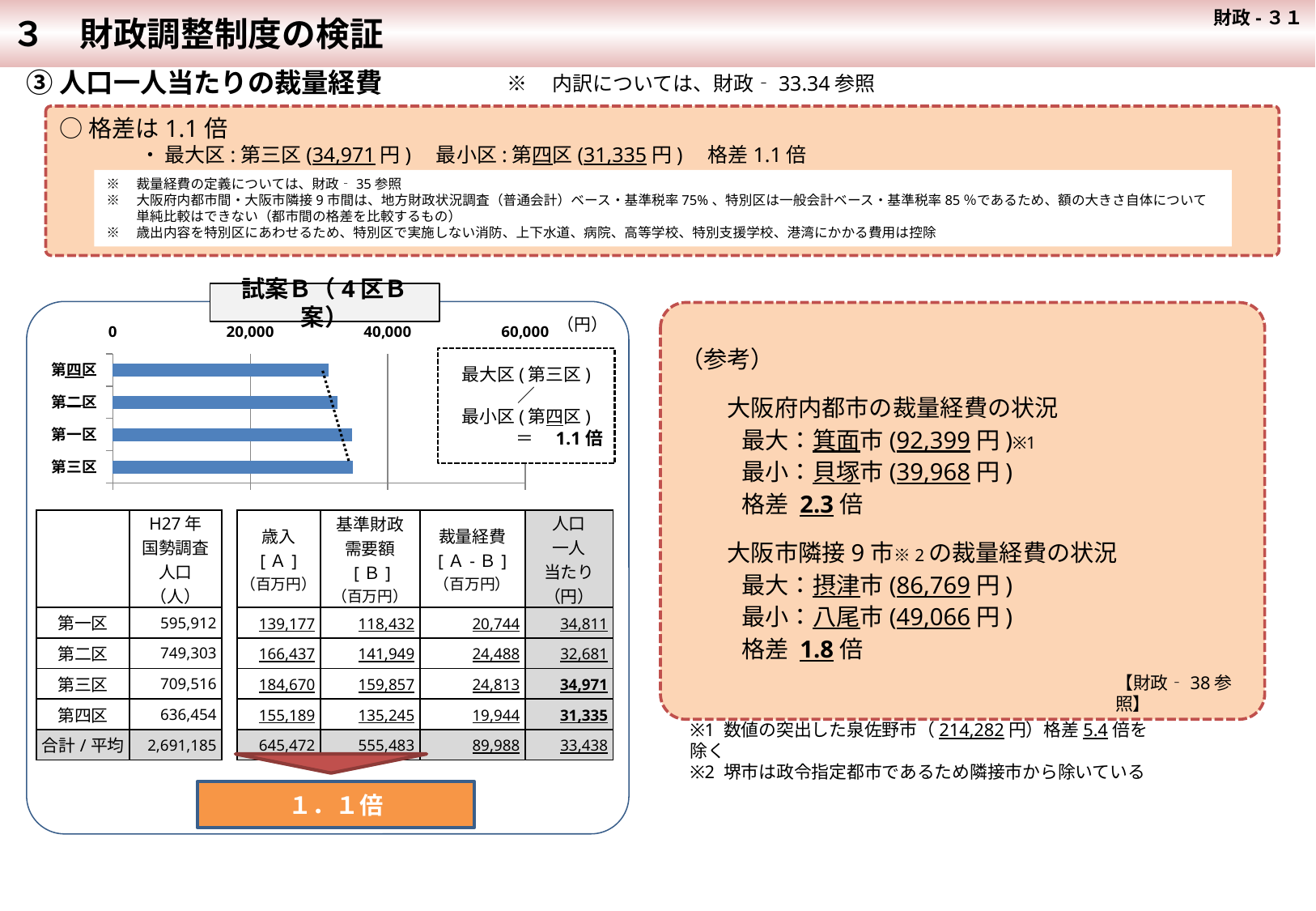
What is the per-capita discretionary expense (人口一人当たり) for 第二区? 32,681 What is the title shown above the bar chart? 試案B（4区B案） What is the per-capita discretionary expense (人口一人当たり) for 第三区? 34,971 Is the value for 第一区 in the bar chart greater or less than 40,000? less Which district has the highest per-capita discretionary expense (人口一人当たり) in the chart? 第三区 How many districts (categories) are plotted in the bar chart? 4 What is the difference between the per-capita discretionary expense of 第三区 and 第四区? 3,636 What kind of chart is shown on the slide? bar chart What is the per-capita discretionary expense (人口一人当たり) for 第四区? 31,335 Which district has the lowest per-capita discretionary expense (人口一人当たり) in the chart? 第四区 What unit is indicated at the end of the chart's horizontal axis? 円 Is the value for 第二区 in the bar chart greater or less than 20,000? greater